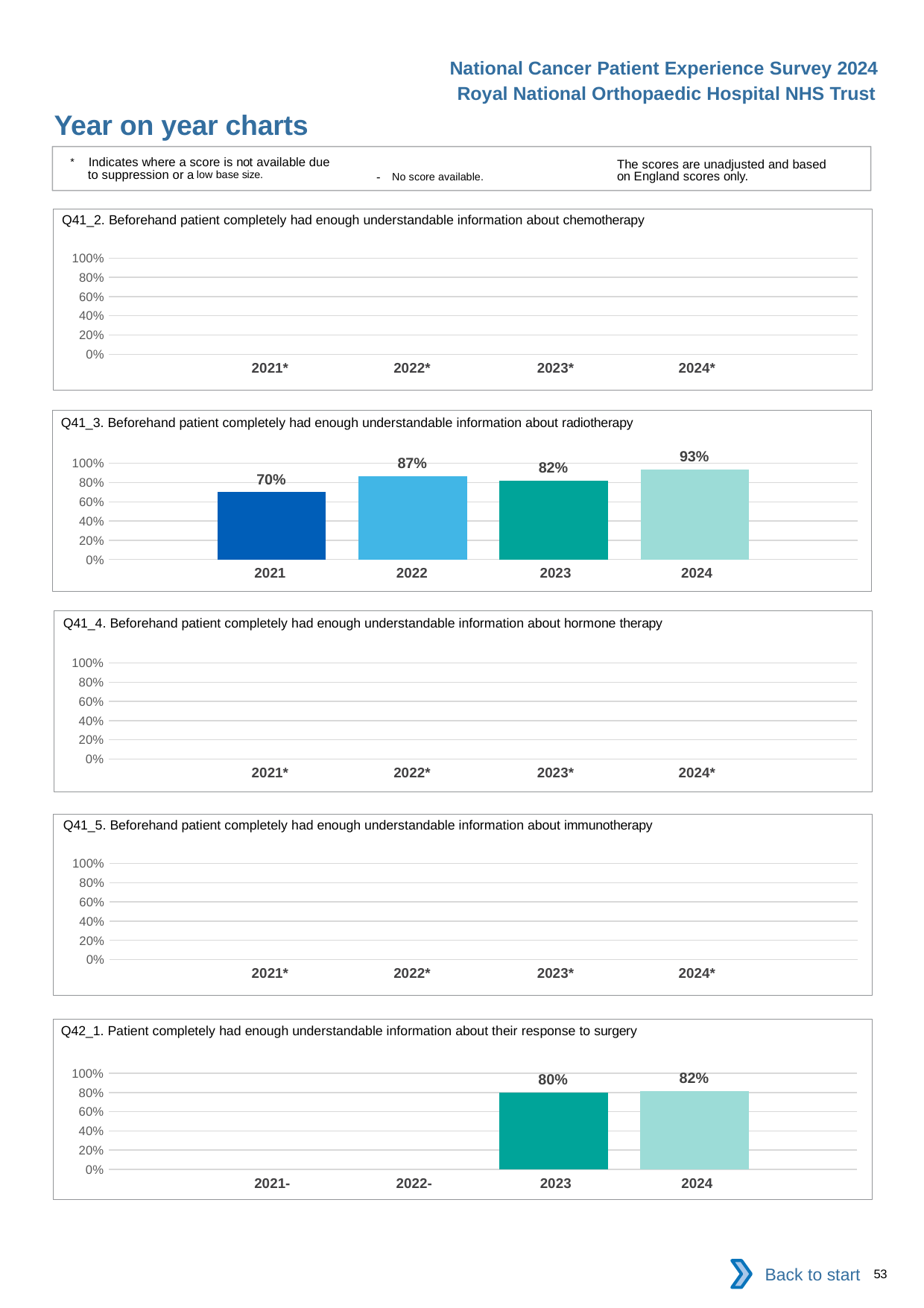
In the Q41_3 radiotherapy chart, how many years have bars plotted? 4 In the Q42_1 surgery chart, what is the value for 2023? 80% In the Q41_3 radiotherapy chart, which is larger, the value for 2022 or the value for 2023? 2022 In the Q42_1 surgery chart, how many years have bars plotted? 2 What kind of chart is the Q41_3 radiotherapy chart? Bar chart In the Q41_3 radiotherapy chart, which year has the highest value? 2024 In the Q41_3 radiotherapy chart, what is the value for 2021? 70% In the Q41_3 radiotherapy chart, what is the difference between the 2024 and 2021 values? 23 percentage points In the Q41_3 radiotherapy chart, what is the value for 2022? 87% In the Q42_1 surgery chart, what is the value for 2024? 82% In the Q41_2 chemotherapy chart, how many years are marked with an asterisk on the x axis? 4 In the Q41_3 radiotherapy chart, which year has the lowest value? 2021